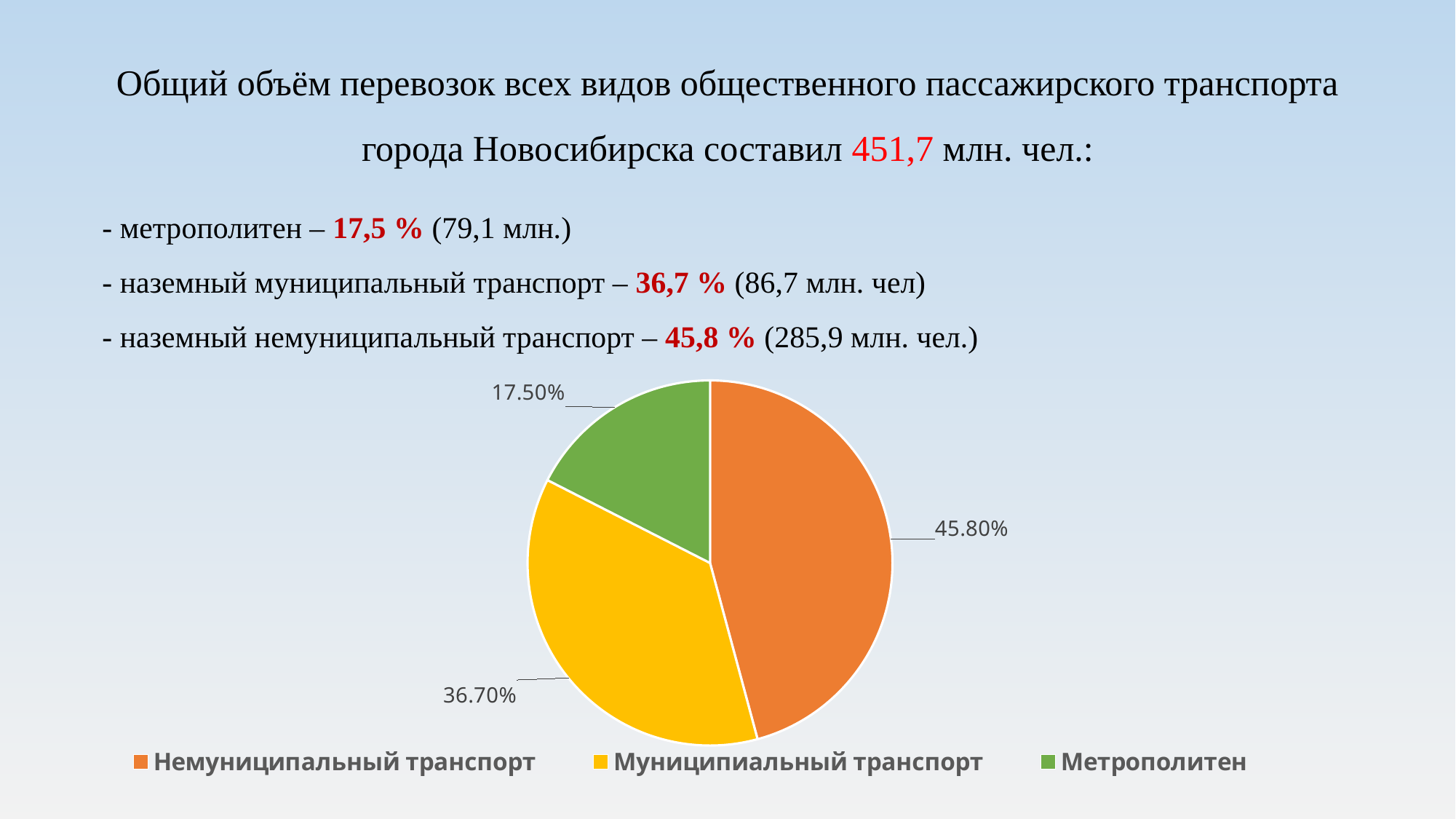
What share of the pie does Метрополитен have? 17.50% What share of the pie does Муниципиальный транспорт have? 36.70% What is the difference in percentage points between Муниципиальный транспорт and Метрополитен? 19.20% What share of the pie does Немуниципальный транспорт have? 45.80% What is the difference in percentage points between Немуниципальный транспорт and Метрополитен? 28.30% What type of chart is shown on the slide? pie chart How many entries does the legend list? 3 How many slices does the pie chart have? 3 Which is larger: the slice for Муниципиальный транспорт or the slice for Метрополитен? Муниципиальный транспорт Which category has the smallest slice of the pie? Метрополитен Which category has the largest slice of the pie? Немуниципальный транспорт What colour is the slice for Метрополитен? green